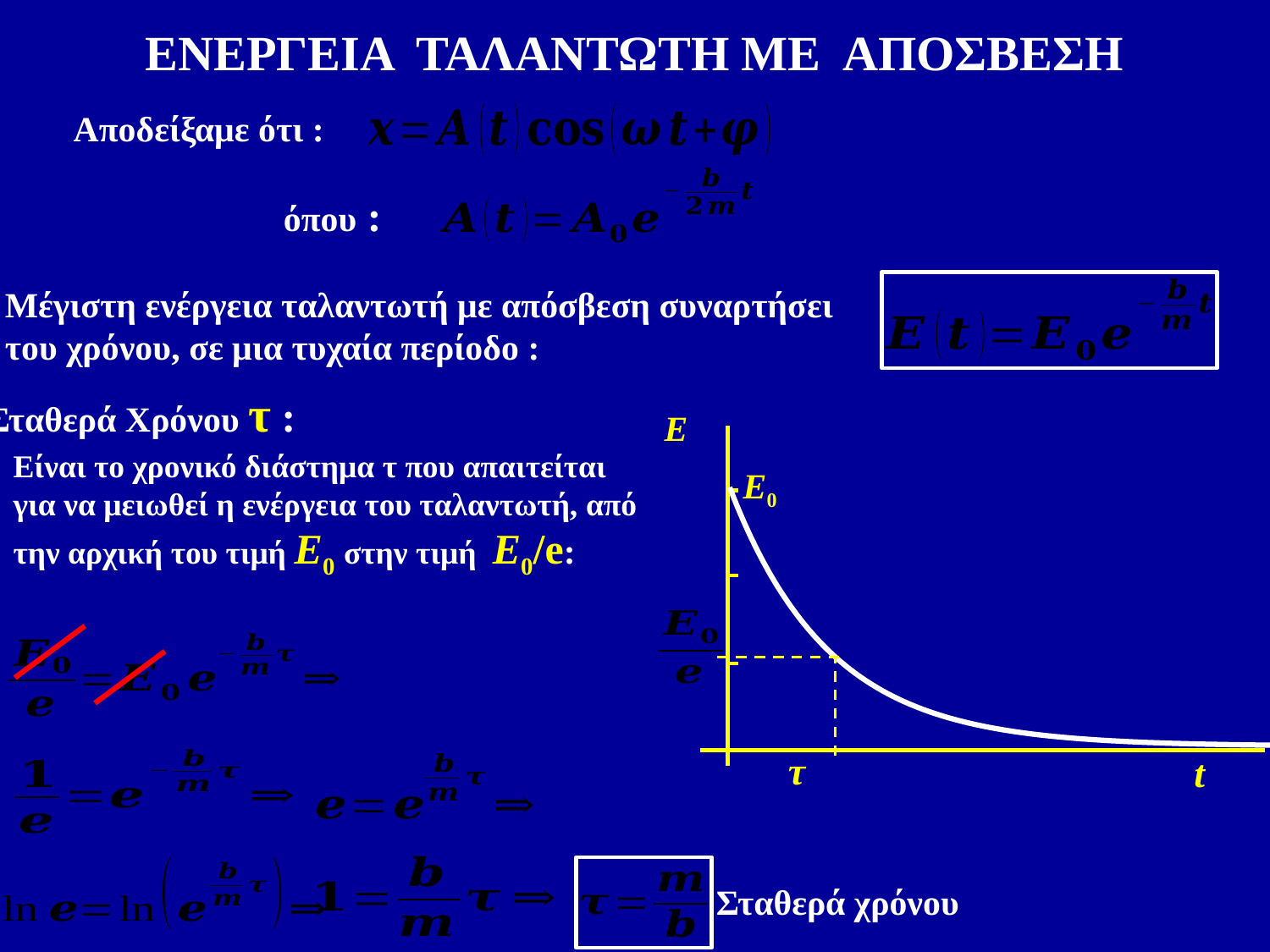
What is the label on the vertical axis of the graph? E Which is larger, the value of E at t = 0 or the value of E at t = τ? the value at t = 0 How many curves are plotted on the graph? 1 Is the value of E at t = τ greater or less than E0? less What kind of chart is shown on the slide? line chart What value does the curve have at t = 0, according to the label on the vertical axis? E0 Does the curve E rise or fall as t increases? falls What is the label on the horizontal axis of the graph? t What value does the curve reach at t = τ, according to the label on the vertical axis? E0/e